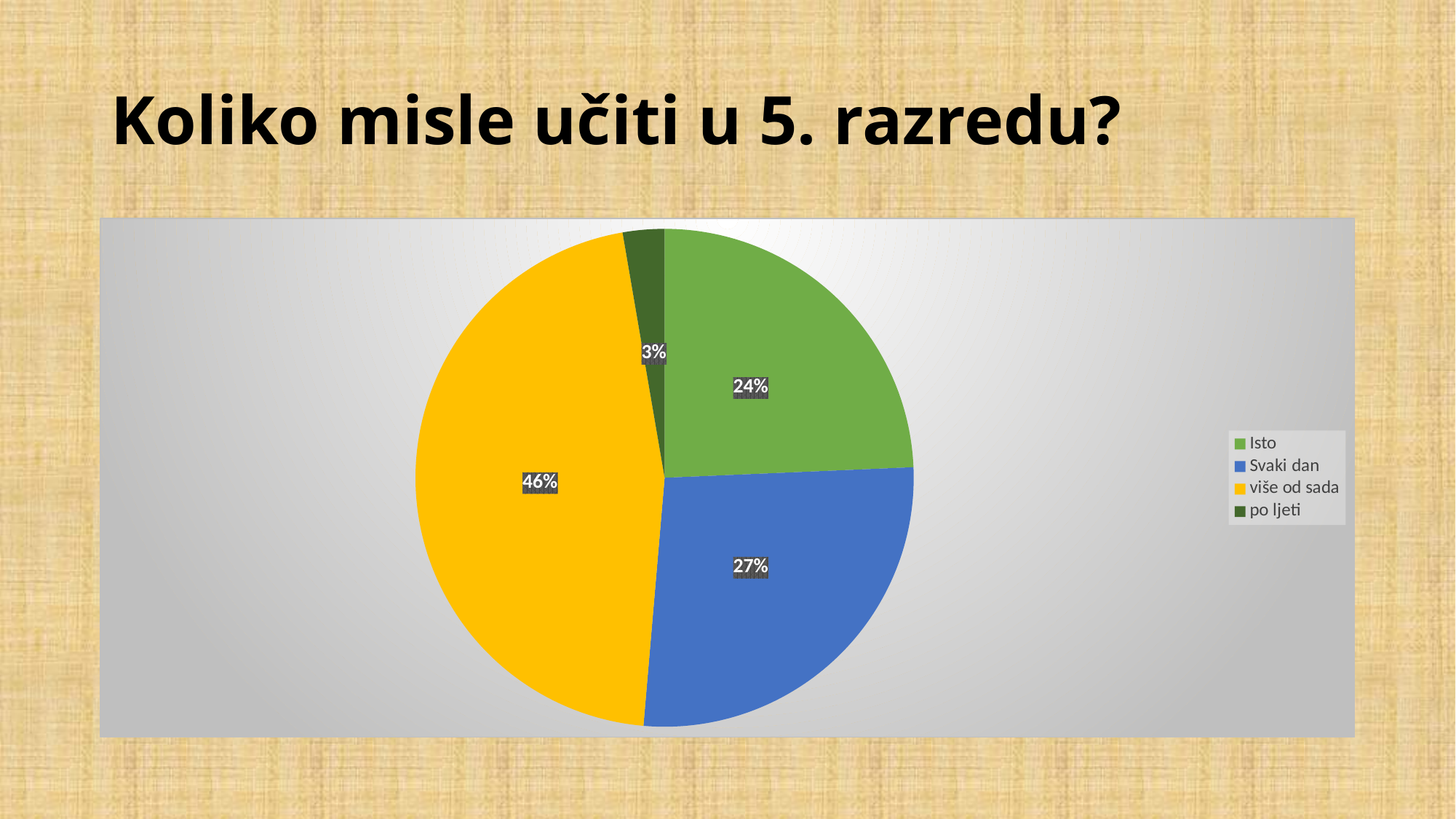
What share of the pie does "Svaki dan" have? 27% Which is larger, the share for "Svaki dan" or the share for "Isto"? Svaki dan How many categories does the pie chart have? 4 What is the difference between the shares of "više od sada" and "Svaki dan"? 19% What kind of chart is shown on the slide? pie chart What share of the pie does "više od sada" have? 46% Which category has the smallest slice of the pie? po ljeti Which category has the largest slice of the pie? više od sada What share of the pie does "Isto" have? 24% What colour is the slice for "Svaki dan"? blue What is the title of the slide above the chart? Koliko misle učiti u 5. razredu?